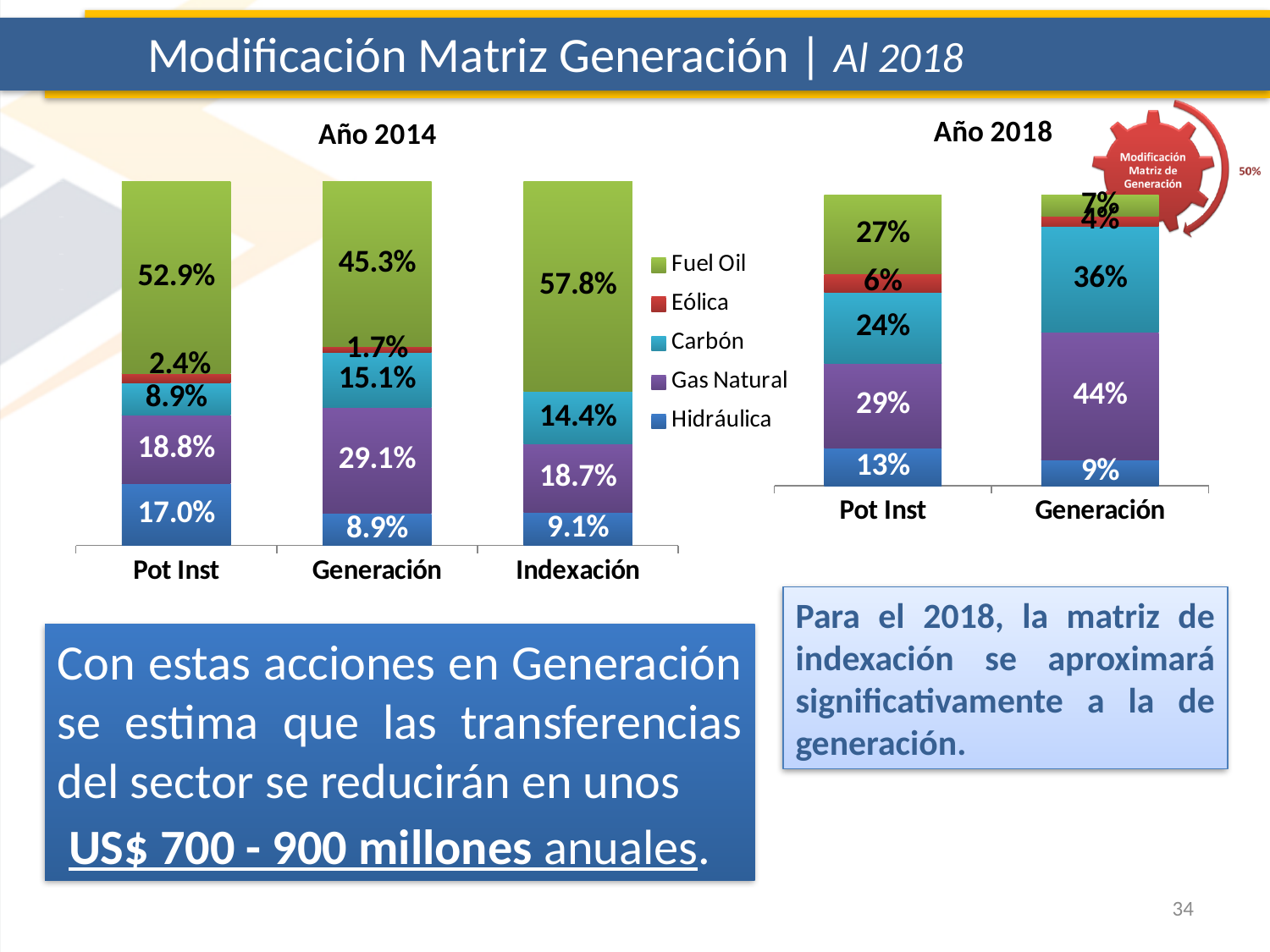
In the Año 2018 chart, what is the Gas Natural share for Pot Inst? 29% In the Año 2018 chart, which category has the lower Hidráulica share? Generación In the Año 2018 chart, what is the Carbón share for Generación? 36% In the Año 2014 chart, what is the difference between the Carbón share for Generación and for Pot Inst? 6.2% In the Año 2014 chart, what is the Gas Natural share for Generación? 29.1% In the Año 2014 chart, what is the Fuel Oil share for Pot Inst? 52.9% How many series does the legend list? 5 In the Año 2014 chart, is the Hidráulica share larger for Pot Inst or for Generación? Pot Inst In the Año 2014 chart, what is the Hidráulica share for Indexación? 9.1% In the Año 2018 chart, what is the difference between the Fuel Oil share for Pot Inst and for Generación? 20% In the Año 2014 chart, which category has the highest Fuel Oil share? Indexación What kind of chart is the Año 2018 chart? Stacked bar chart